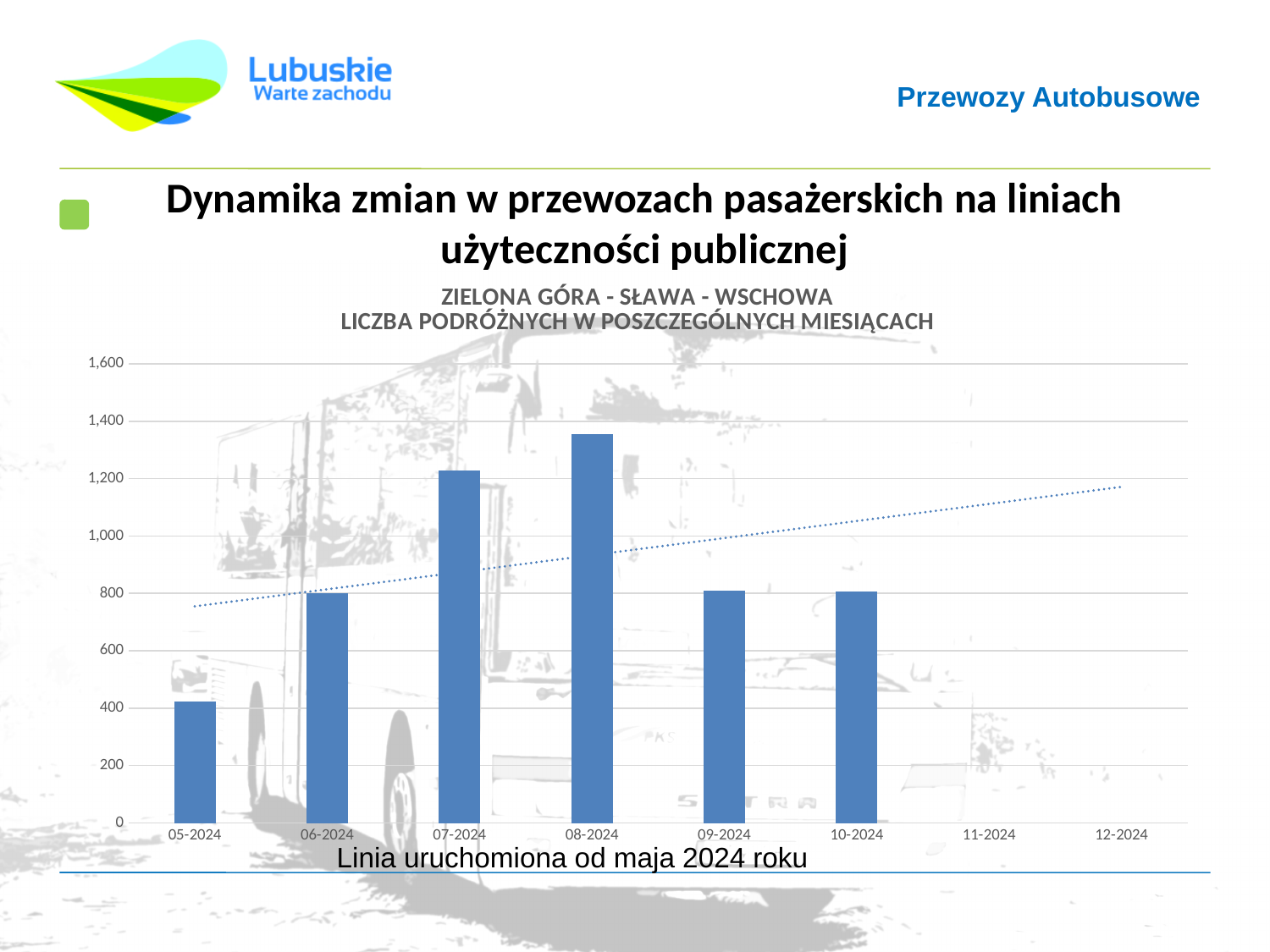
What kind of chart is shown on the slide? bar chart Does the dotted trend line rise or fall from left to right? rises Which month has the highest number of passengers? 08-2024 Among the months with a bar plotted, which month has the lowest number of passengers? 05-2024 How many month labels are shown on the x axis? 8 How many months have a bar plotted? 6 Which is larger, the value for 05-2024 or the value for 06-2024? 06-2024 Is the value for 05-2024 greater or less than 600? less Which is larger, the value for 07-2024 or the value for 08-2024? 08-2024 Is the value for 08-2024 greater or less than 1,200? greater Is the value for 07-2024 greater or less than 1,000? greater